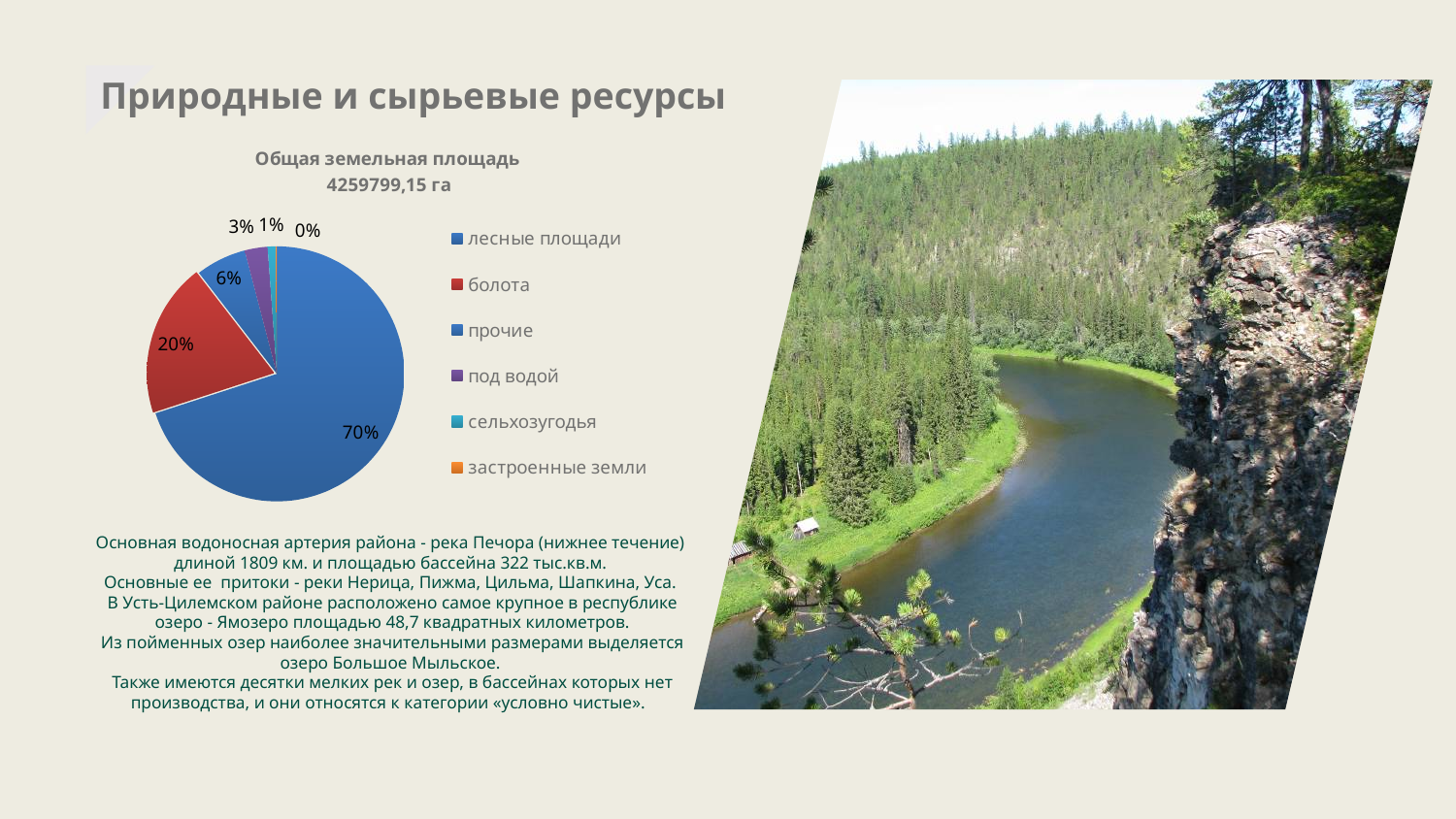
What share of the pie does "под водой" take? 3% What share of the pie does "болота" take? 20% What share of the pie does "прочие" take? 6% Which category has the smallest slice of the pie? застроенные земли Which is larger, the share for "болота" or the share for "прочие"? болота What kind of chart is shown on the slide? pie chart What is the difference in percentage points between "лесные площади" and "болота"? 50 Which category has the largest slice of the pie? лесные площади What is the title of the chart? Общая земельная площадь 4259799,15 га How many categories does the legend of the pie chart list? 6